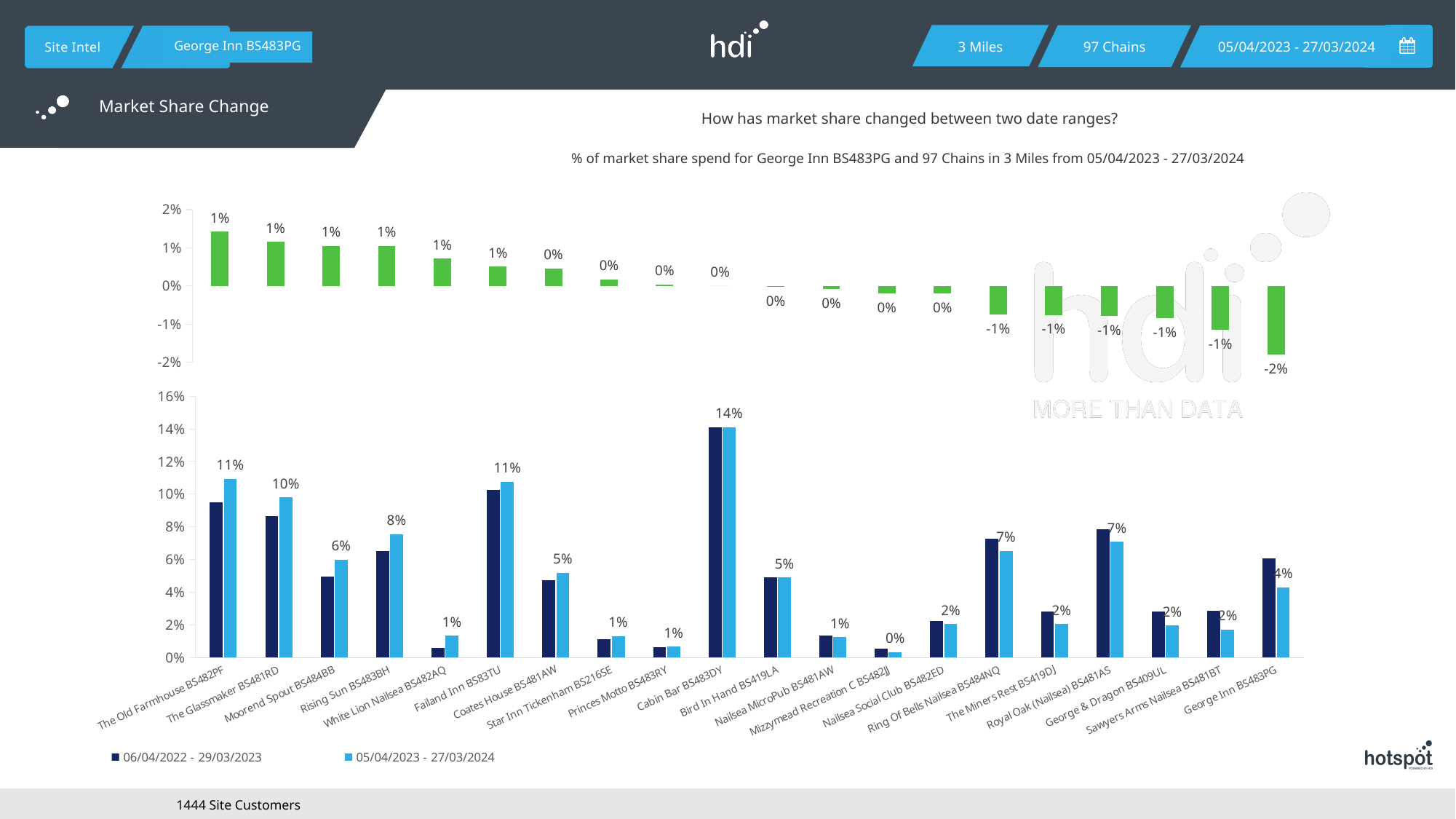
What kind of chart is the bottom chart on the slide? bar chart In the bottom chart, which venue has the highest market share for 05/04/2023 - 27/03/2024? Cabin Bar BS483DY In the bottom chart, what is the difference between the 05/04/2023 - 27/03/2024 market share of Cabin Bar BS483DY and Failand Inn BS83TU? 3% In the bottom chart, what is the market share for George Inn BS483PG in 05/04/2023 - 27/03/2024? 4% In the bottom chart, is the 06/04/2022 - 29/03/2023 value for Cabin Bar BS483DY greater or less than 12%? greater How many venues are shown on the x axis of the bottom chart? 20 In the bottom chart, what is the market share for Cabin Bar BS483DY in 05/04/2023 - 27/03/2024? 14% How many series does the legend of the bottom chart list? 2 What colour are the bars for the 05/04/2023 - 27/03/2024 series in the bottom chart? light blue In the bottom chart, which has the larger 05/04/2023 - 27/03/2024 market share: Rising Sun BS483BH or Moorend Spout BS484BB? Rising Sun BS483BH In the bottom chart, what is the market share for The Old Farmhouse BS482PF in 05/04/2023 - 27/03/2024? 11% In the top chart, what is the value of the rightmost bar? -2%